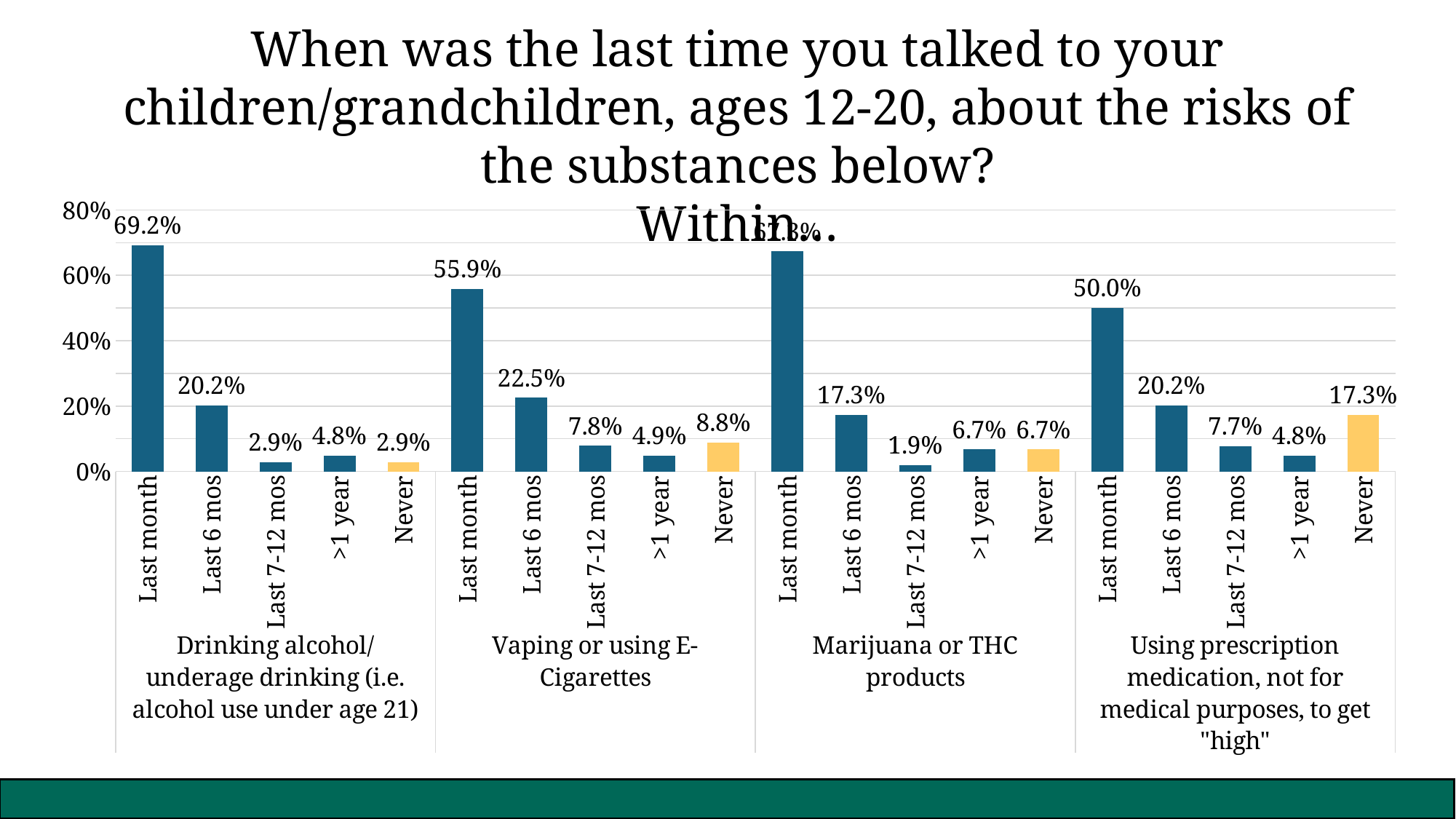
What is the difference between the "Last 6 mos" value for Vaping or using E-Cigarettes and the "Last 6 mos" value for Marijuana or THC products? 5.2% How many substance groups are shown on the x axis? 4 What percentage of respondents talked about drinking alcohol/underage drinking within the last month? 69.2% Which time category's bars are coloured yellow rather than blue? Never Is the "Last month" value for Vaping or using E-Cigarettes greater or less than 40%? greater What is the value for "Never" under Vaping or using E-Cigarettes? 8.8% Within the Marijuana or THC products group, which time category has the lowest value? Last 7-12 mos What kind of chart is shown on the slide? bar chart Within the Drinking alcohol/underage drinking group, which time category has the highest value? Last month What is the value for "Last 7-12 mos" under Marijuana or THC products? 1.9% Which is larger: the "Never" value for Using prescription medication or the "Never" value for Vaping or using E-Cigarettes? Using prescription medication What is the value for "Last month" under Using prescription medication, not for medical purposes, to get "high"? 50.0%